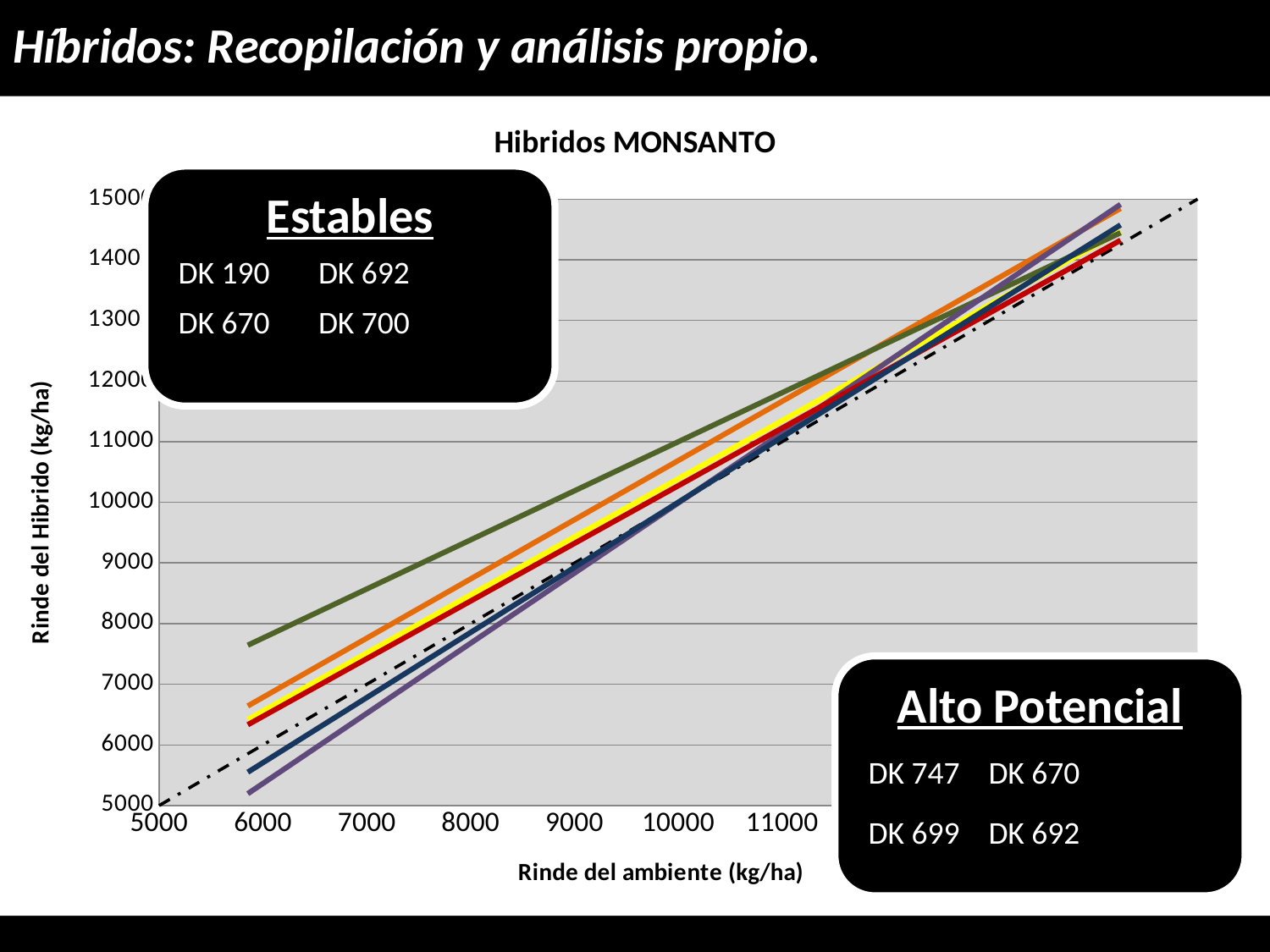
How many solid coloured lines are plotted on the chart (excluding the dashed black line)? 6 Do the plotted lines rise or fall as the x-axis value (Rinde del ambiente) increases? rise What is the label of the x axis of the chart? Rinde del ambiente (kg/ha) At around 6000 on the x axis, which is higher, the green line or the blue line? green At the left end of the lines (around 6000 on the x axis), is the green line greater or less than 7000? greater At the left end of the lines (around 6000 on the x axis), is the orange line greater or less than 6000? greater What is the lowest value shown on the x axis of the chart? 5000 At the left end of the lines (around 6000 on the x axis), is the purple line greater or less than 6000? less Which coloured line has the lowest value at the left end of the chart (around 6000 on the x axis)? purple Which coloured line has the highest value at the left end of the chart (around 6000 on the x axis)? green What kind of chart is shown on the slide? line chart What is the title of the chart? Hibridos MONSANTO